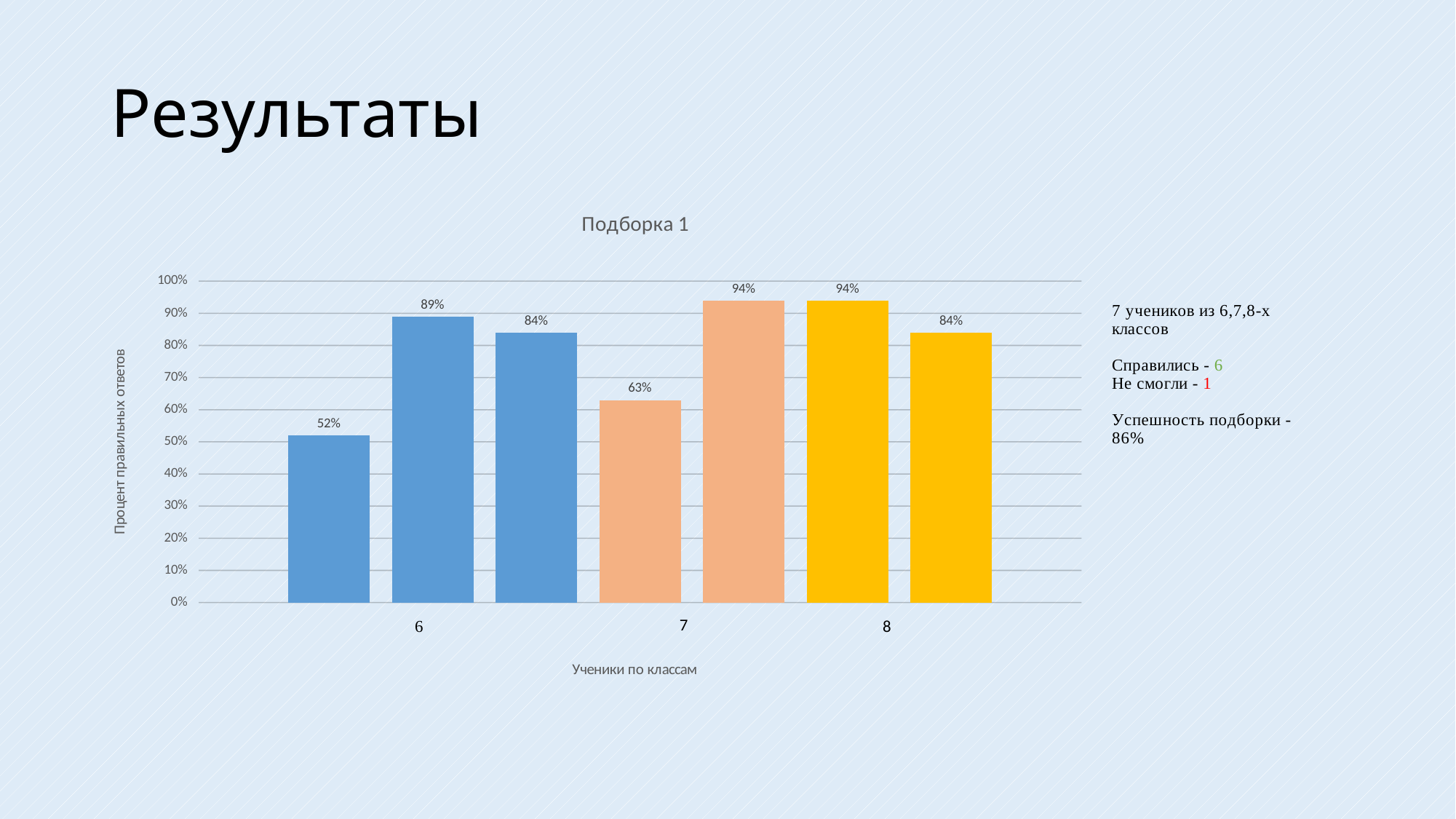
Which is larger: the second bar in the class 6 group or the first bar in the class 7 group? The second bar in the class 6 group (89%) What is the value of the highest bars in the chart? 94% How many bars are shown for class 6? 3 What is the title of the x axis? Ученики по классам What is the title of the chart? Подборка 1 What is the value of the first (leftmost) bar in the class 6 group? 52% What is the difference between the highest bar value (94%) and the lowest bar value (52%)? 42 percentage points What is the value of the lowest bar in the chart? 52% What kind of chart is shown on the slide? Bar chart How many bars are plotted in the chart in total? 7 What is the value of the first bar in the class 7 group? 63% What is the value of the second bar in the class 8 group? 84%